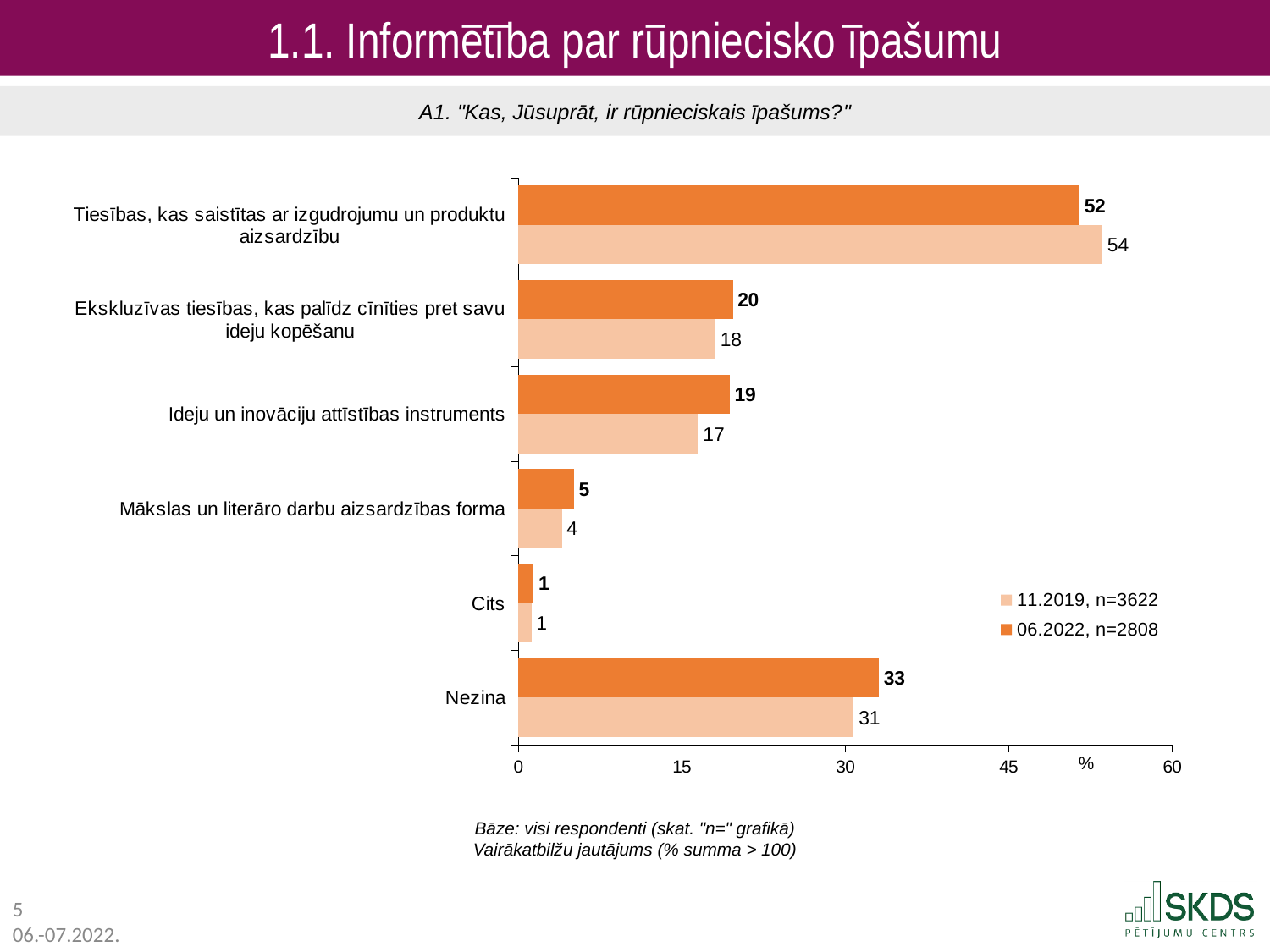
What is the value for "Nezina" in the 11.2019 series? 31 Is the 06.2022 value for "Nezina" greater or less than 30? greater How many series does the legend list? 2 Which is larger for "Ekskluzīvas tiesības, kas palīdz cīnīties pret savu ideju kopēšanu": the 11.2019 value or the 06.2022 value? 06.2022 What is the sample size (n) for the 06.2022 series shown in the legend? n=2808 What kind of chart is shown on the slide? Bar chart What is the difference between the 11.2019 and 06.2022 values for "Tiesības, kas saistītas ar izgudrojumu un produktu aizsardzību"? 2 What is the value for "Ideju un inovāciju attīstības instruments" in the 06.2022 series? 19 How many categories are shown on the chart? 6 What is the value for "Tiesības, kas saistītas ar izgudrojumu un produktu aizsardzību" in the 06.2022 series? 52 Which category has the highest value in the 06.2022 series? Tiesības, kas saistītas ar izgudrojumu un produktu aizsardzību Which category has the lowest value in the 11.2019 series? Cits